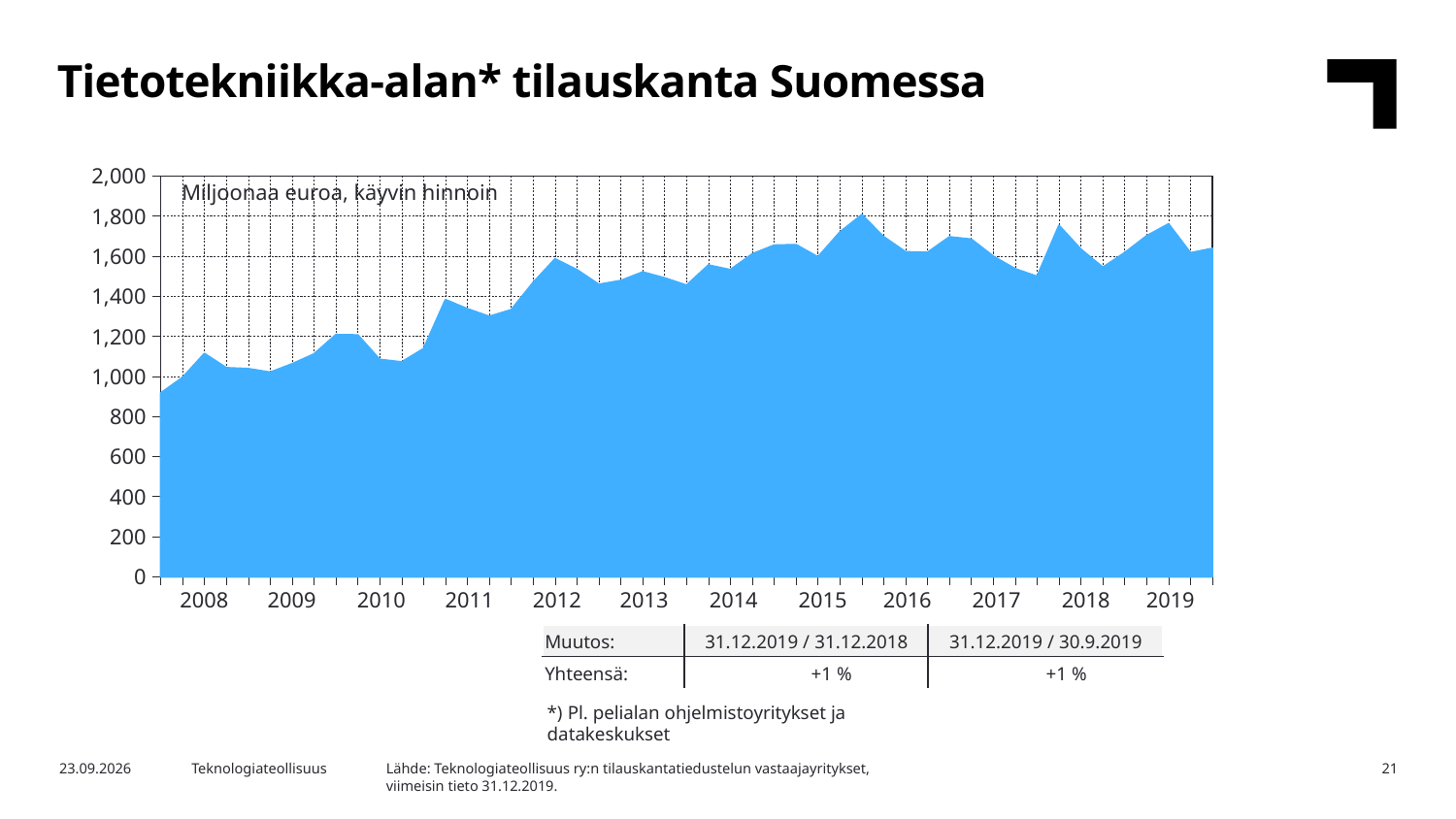
Is the value at the end of the series in 2019 greater or less than 1,400? greater What unit is stated inside the chart area? Miljoonaa euroa, käyvin hinnoin In which year does the series reach its highest point? 2015 Is the value around 2014 greater or less than 1,400? greater Is the value at the start of the series in 2008 greater or less than 1,000? less Which is larger, the value at the start of 2008 or the value at the end of 2019? end of 2019 Does the order backlog generally rise or fall from 2008 to 2019? rise How many years are labelled on the x axis of the chart? 12 What is the title of the chart on the slide? Tietotekniikka-alan* tilauskanta Suomessa What kind of chart is shown on the slide? area chart According to the table below the chart, what is the change (Muutos) for 31.12.2019 / 31.12.2018? +1 %